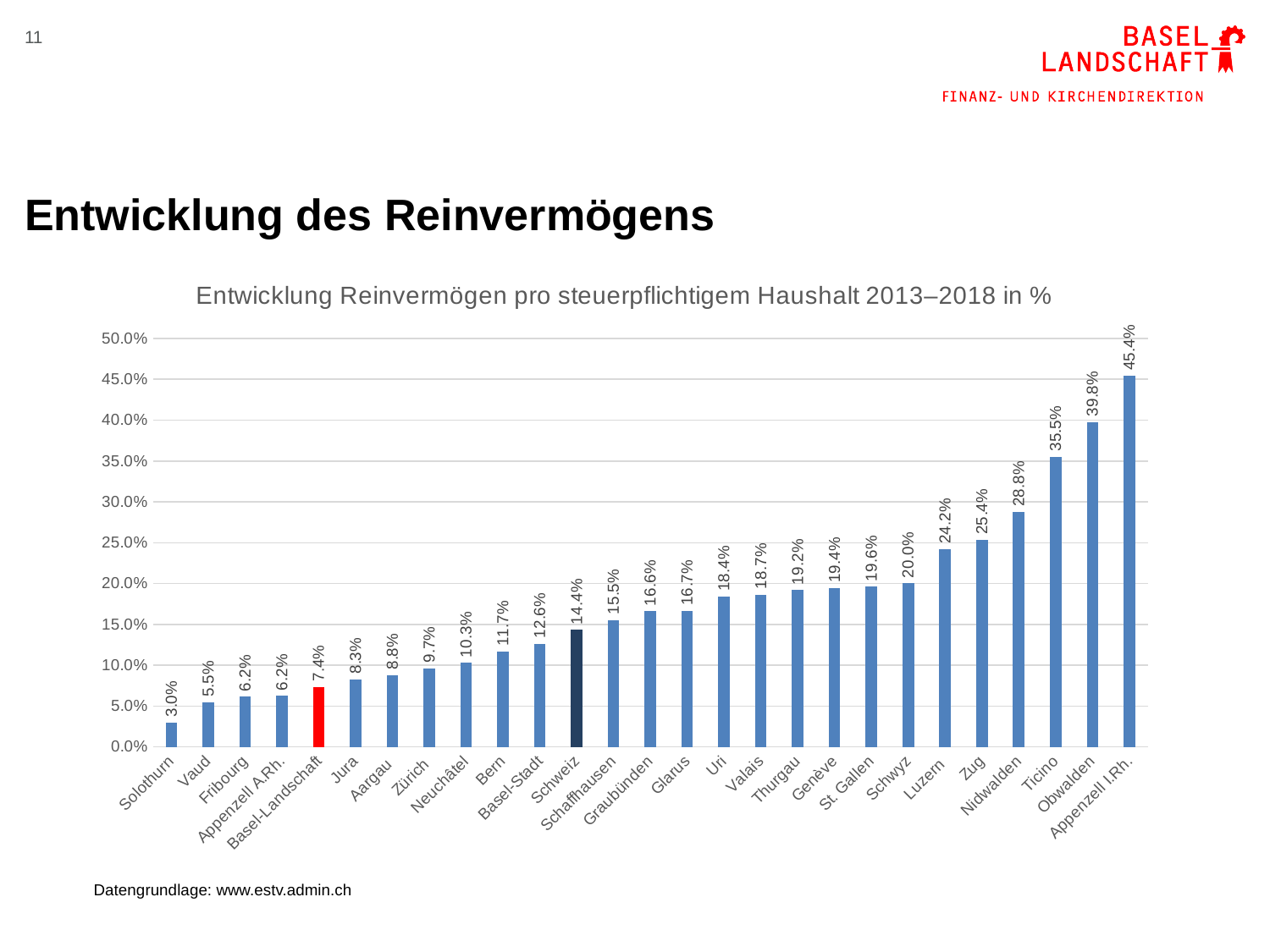
What is the difference between the values for Appenzell I.Rh. and Solothurn? 42.4% How many bars are shown in the chart? 27 Which is larger, the value for Ticino or the value for Obwalden? Obwalden Which bar is coloured red? Basel-Landschaft Which canton has the highest value? Appenzell I.Rh. What is the value for Zug? 25.4% Is the value for Nidwalden greater or less than 25.0%? greater What is the difference between the values for Schweiz and Basel-Landschaft? 7.0% What is the value for Basel-Landschaft? 7.4% Which canton has the lowest value? Solothurn What kind of chart is shown on the slide? bar chart What is the value for Schweiz? 14.4%